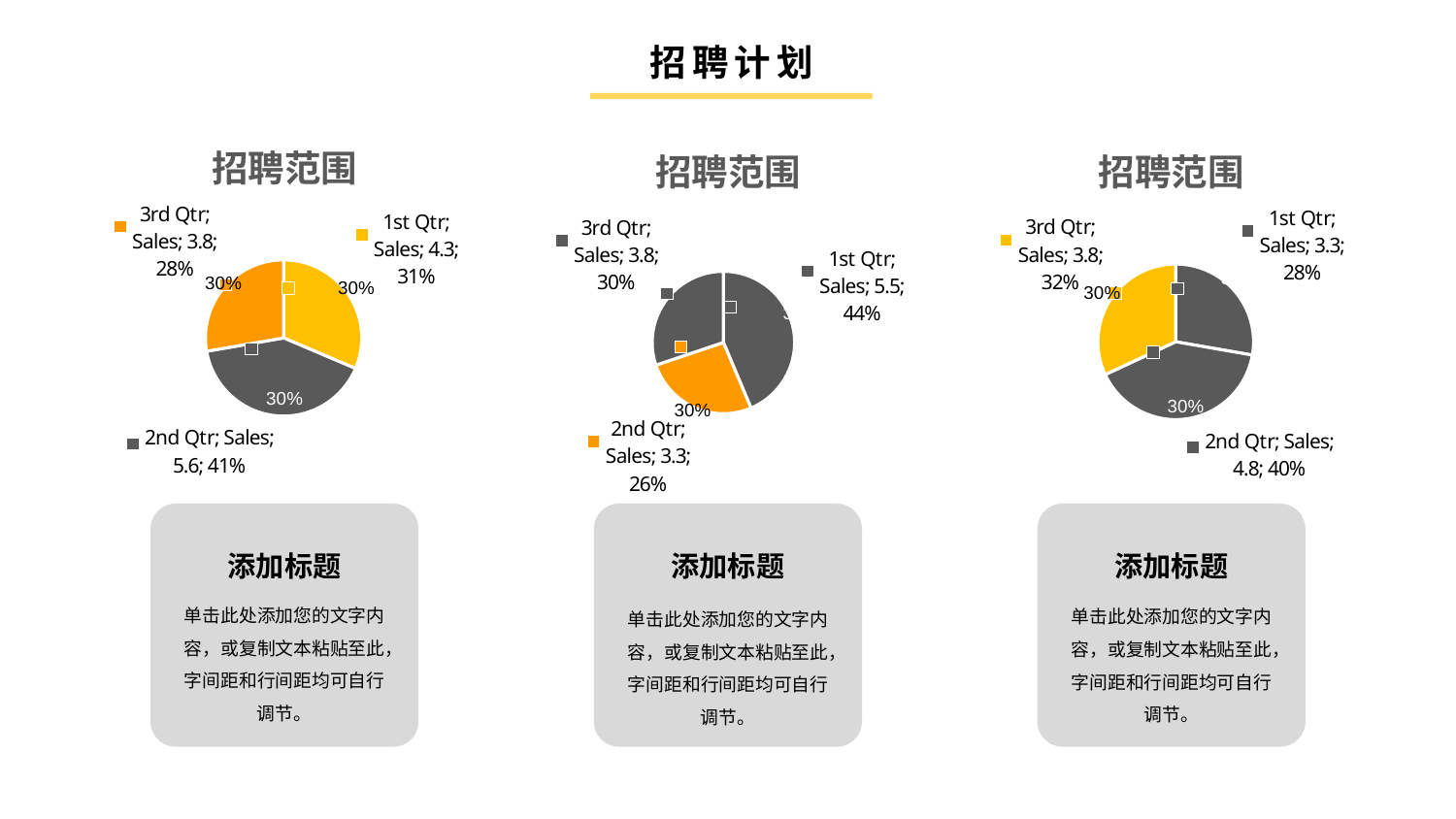
What kind of chart is the left-hand chart on the slide? pie chart In the left-hand pie chart, which quarter has the largest slice? 2nd Qtr In the middle pie chart, what share of the pie does 3rd Qtr take? 30% What is the title of the middle chart? 招聘范围 In the left-hand pie chart, what is the Sales value for 2nd Qtr? 5.6 In the left-hand pie chart, what share of the pie does 1st Qtr take? 31% In the right-hand pie chart, which is larger, the Sales value for 1st Qtr or 3rd Qtr? 3rd Qtr How many slices does the middle pie chart have? 3 In the right-hand pie chart, what is the Sales value for 2nd Qtr? 4.8 In the right-hand pie chart, what is the difference between the Sales values for 2nd Qtr and 1st Qtr? 1.5 In the middle pie chart, which quarter has the smallest slice? 2nd Qtr In the middle pie chart, what is the Sales value for 1st Qtr? 5.5